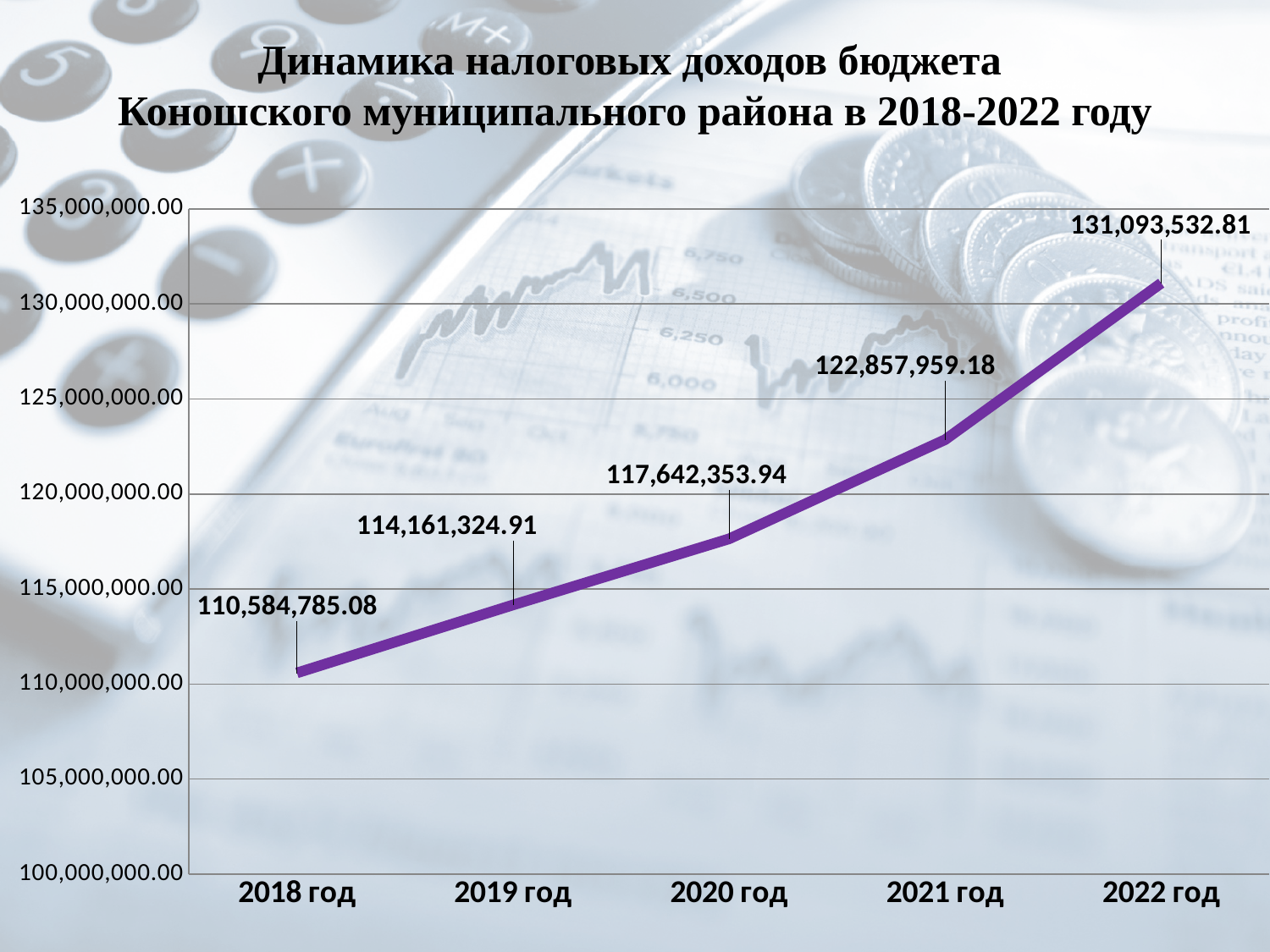
Which is larger, the value for 2019 год or the value for 2020 год? 2020 год Do the values rise or fall from 2018 год to 2022 год? rise What is the difference between the values for 2022 год and 2021 год? 8,235,573.63 Which year has the lowest value? 2018 год Which year has the highest value? 2022 год What is the value for 2020 год? 117,642,353.94 What is the value for 2018 год? 110,584,785.08 How many years are plotted on the chart? 5 What kind of chart is shown on the slide? line chart What is the value for 2021 год? 122,857,959.18 What is the difference between the values for 2019 год and 2018 год? 3,576,539.83 Is the value for 2021 год greater or less than 125,000,000.00? less